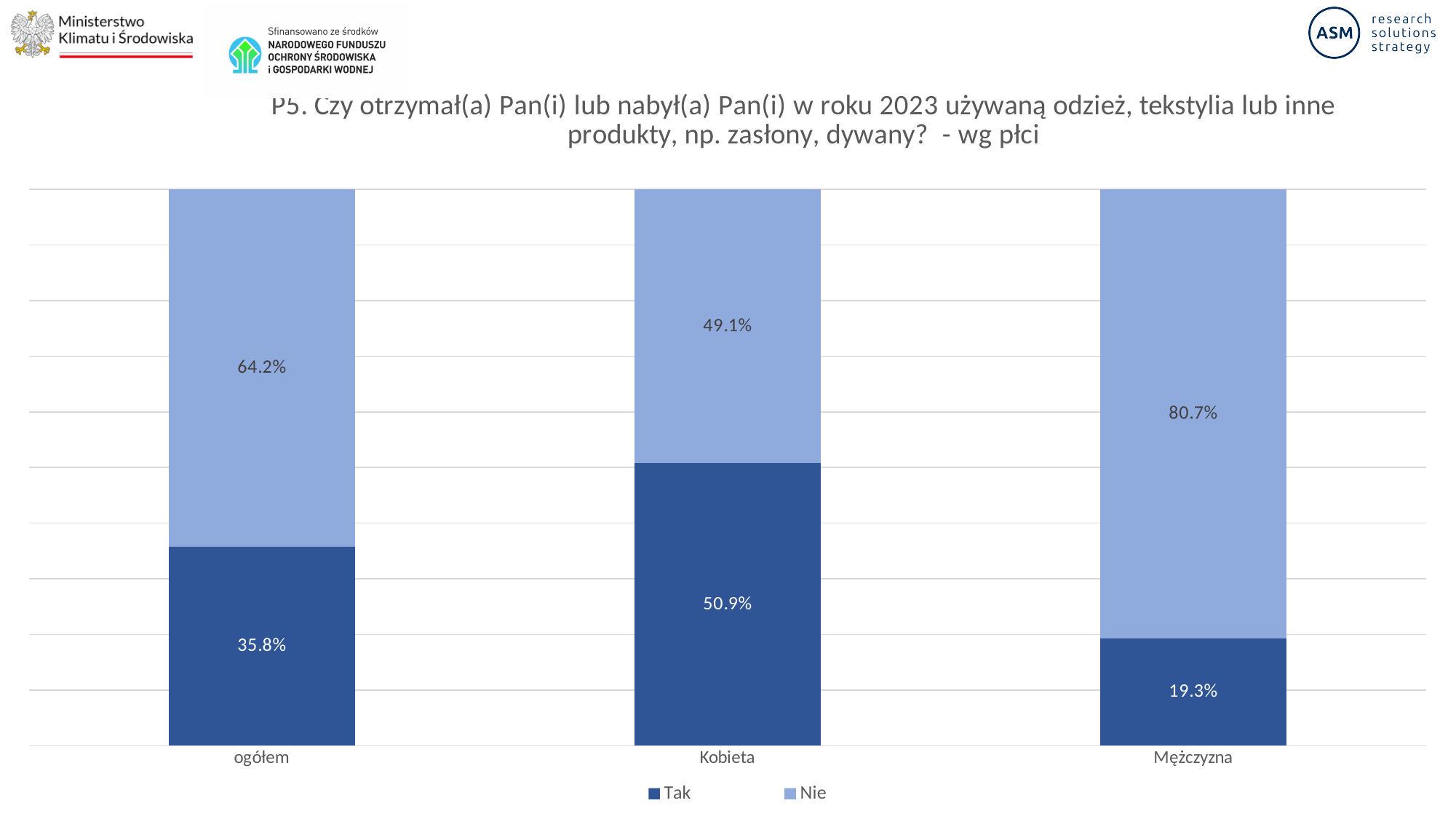
What is the value of "Tak" for Kobieta? 50.9% What is the value of "Nie" for Mężczyzna? 80.7% Which is larger: the "Nie" value for Kobieta or for Mężczyzna? Mężczyzna How many series does the legend list? 2 What kind of chart is shown on the slide? Stacked bar chart Which category has the highest "Tak" value? Kobieta Which category has the lowest "Tak" value? Mężczyzna What is the value of "Nie" for ogółem? 64.2% What is the difference between the "Tak" values for Kobieta and Mężczyzna? 31.6% What is the value of "Tak" for ogółem? 35.8% How many categories are shown on the x axis? 3 What is the total of the stacked bar for Mężczyzna? 100%